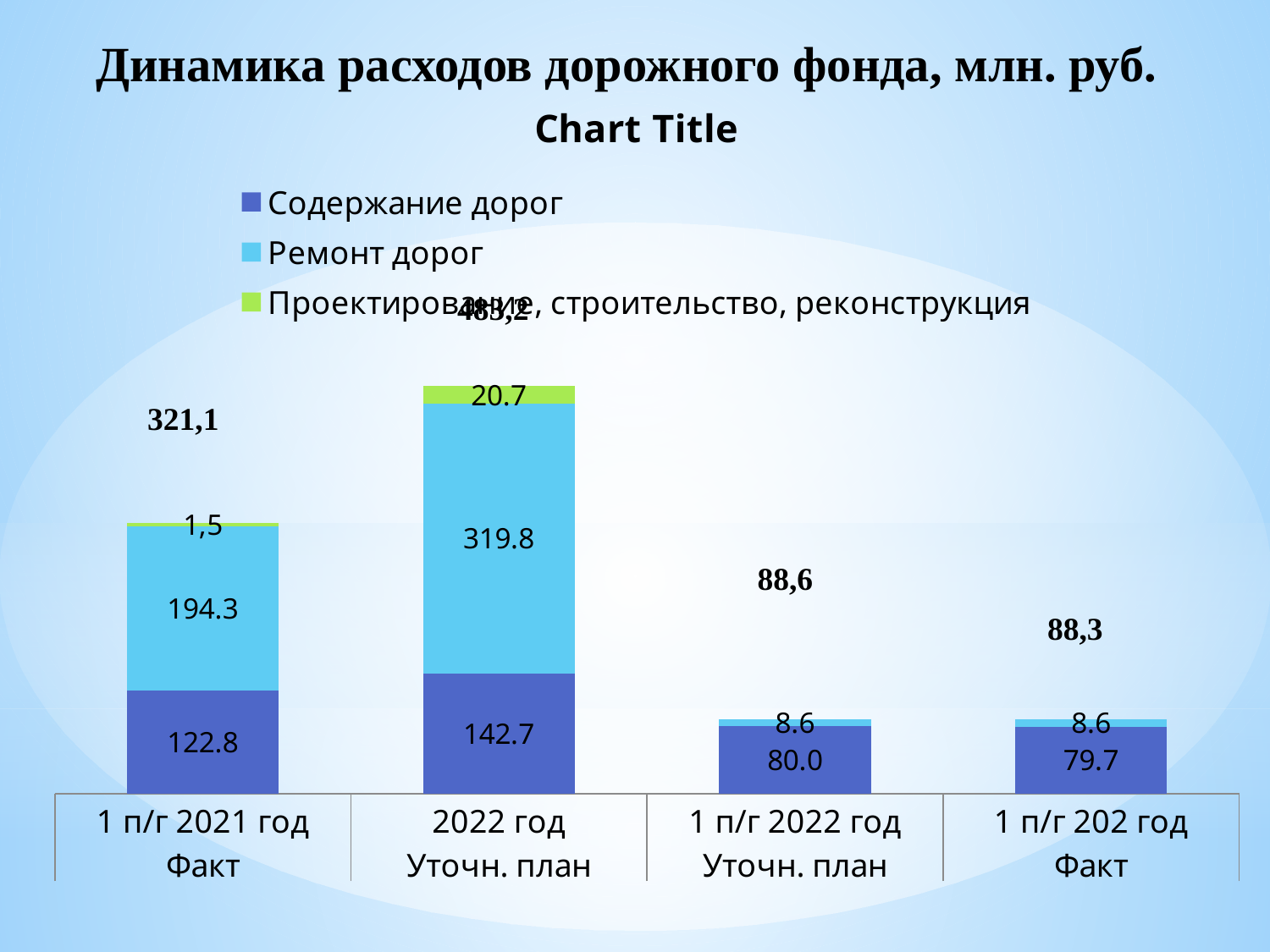
What is the value of Содержание дорог for 2022 год Уточн. план? 142.7 What is the total of the stacked bar for 1 п/г 2022 год Уточн. план? 88,6 What is the value of Ремонт дорог for 1 п/г 2021 год Факт? 194.3 What is the value of Содержание дорог for 1 п/г 202 год Факт? 79.7 What kind of chart is shown on the slide? Stacked bar chart What is the difference between the Ремонт дорог values for 2022 год Уточн. план and 1 п/г 2021 год Факт? 125.5 Which is larger: Содержание дорог for 1 п/г 2021 год Факт or for 2022 год Уточн. план? 2022 год Уточн. план Which category has the highest value for Ремонт дорог? 2022 год Уточн. план What is the value of Проектирование, строительство, реконструкция for 2022 год Уточн. план? 20.7 How many series does the legend list? 3 Which category has the highest value for Содержание дорог? 2022 год Уточн. план How many categories are shown on the x axis? 4